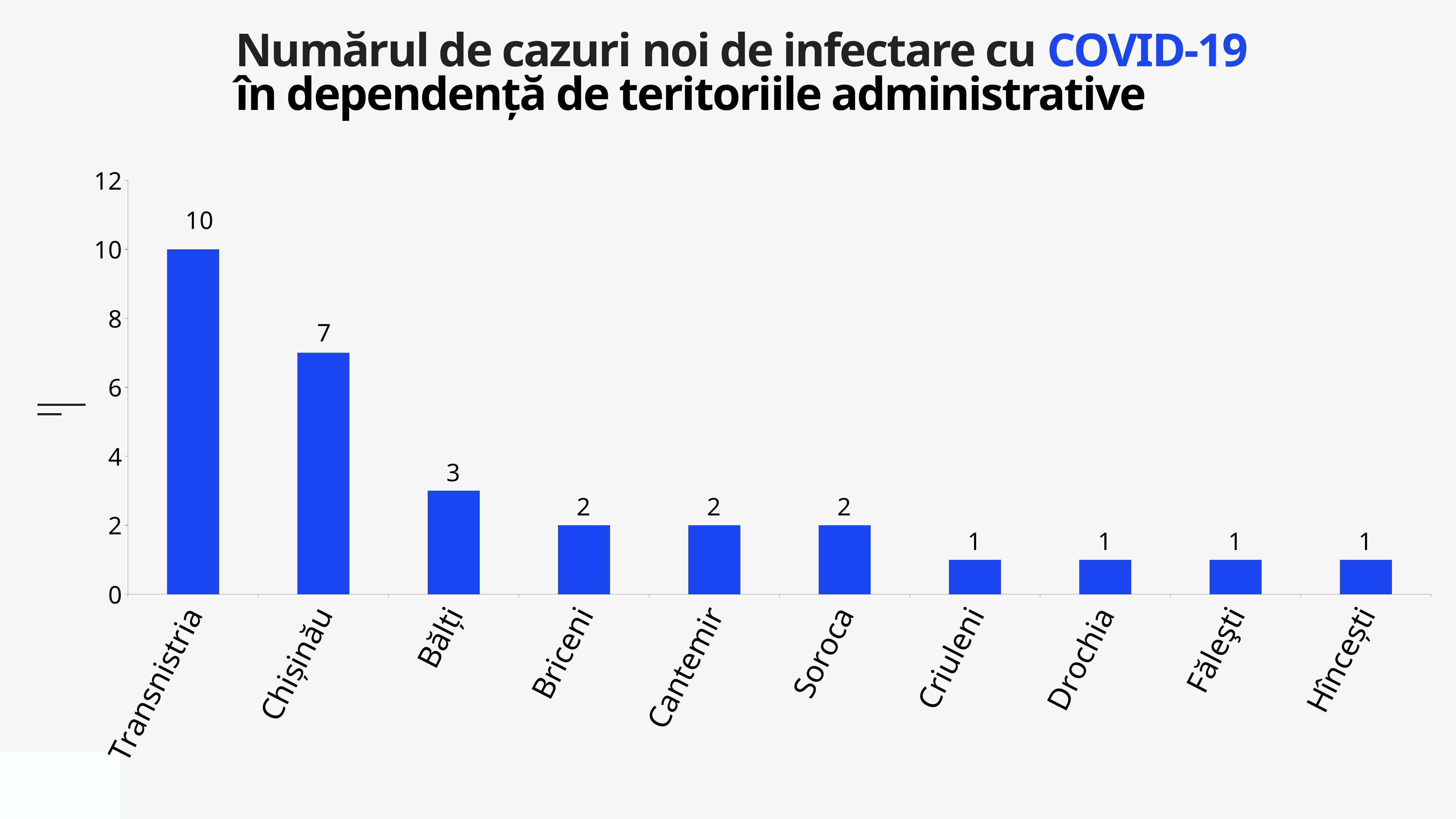
What is the value shown for Bălți? 3 What is the number of new COVID-19 cases for Chișinău? 7 What is the difference between the values for Chișinău and Bălți? 4 What is the value shown for Soroca? 2 How many territories are shown on the x axis? 10 Do the values rise or fall from left to right along the x axis? fall What is the number of new COVID-19 cases for Transnistria? 10 Which has a larger value, Bălți or Briceni? Bălți Is the value for Transnistria greater or less than 8? greater Which territory has the highest number of new cases? Transnistria What is the difference between the values for Transnistria and Chișinău? 3 What kind of chart is shown on the slide? bar chart